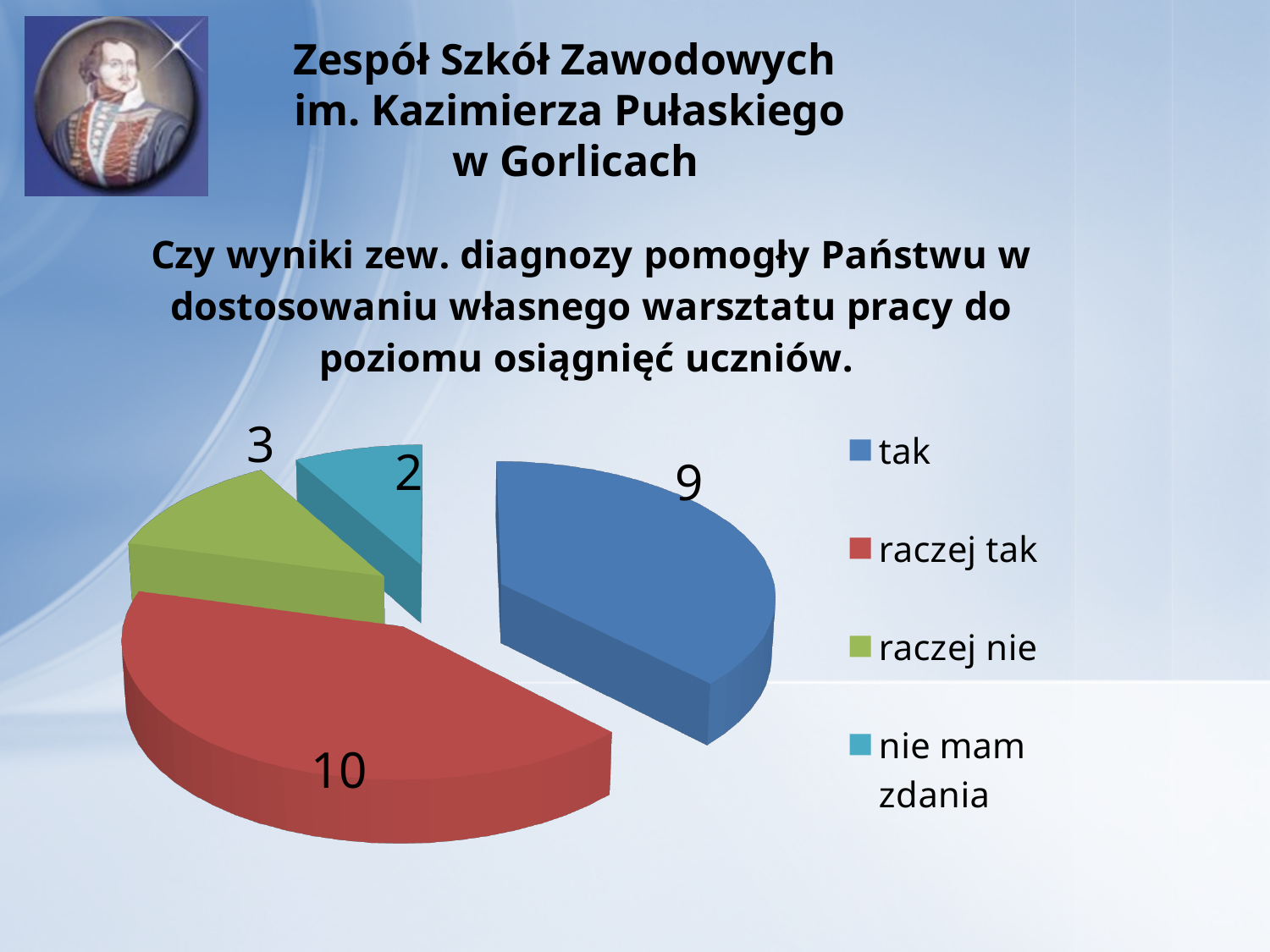
What is the difference between the values for "raczej tak" and "tak"? 1 How many slices does the pie chart have? 4 Which category has the largest slice in the pie chart? raczej tak What is the total of all slices in the pie chart? 24 How many entries does the legend of the pie chart list? 4 What is the value for "raczej tak" in the pie chart? 10 What is the value for "tak" in the pie chart? 9 Which category has the smallest slice in the pie chart? nie mam zdania What type of chart is shown on the slide? pie chart Which is larger, the value for "raczej nie" or the value for "nie mam zdania"? raczej nie What is the value for "raczej nie" in the pie chart? 3 What is the value for "nie mam zdania" in the pie chart? 2